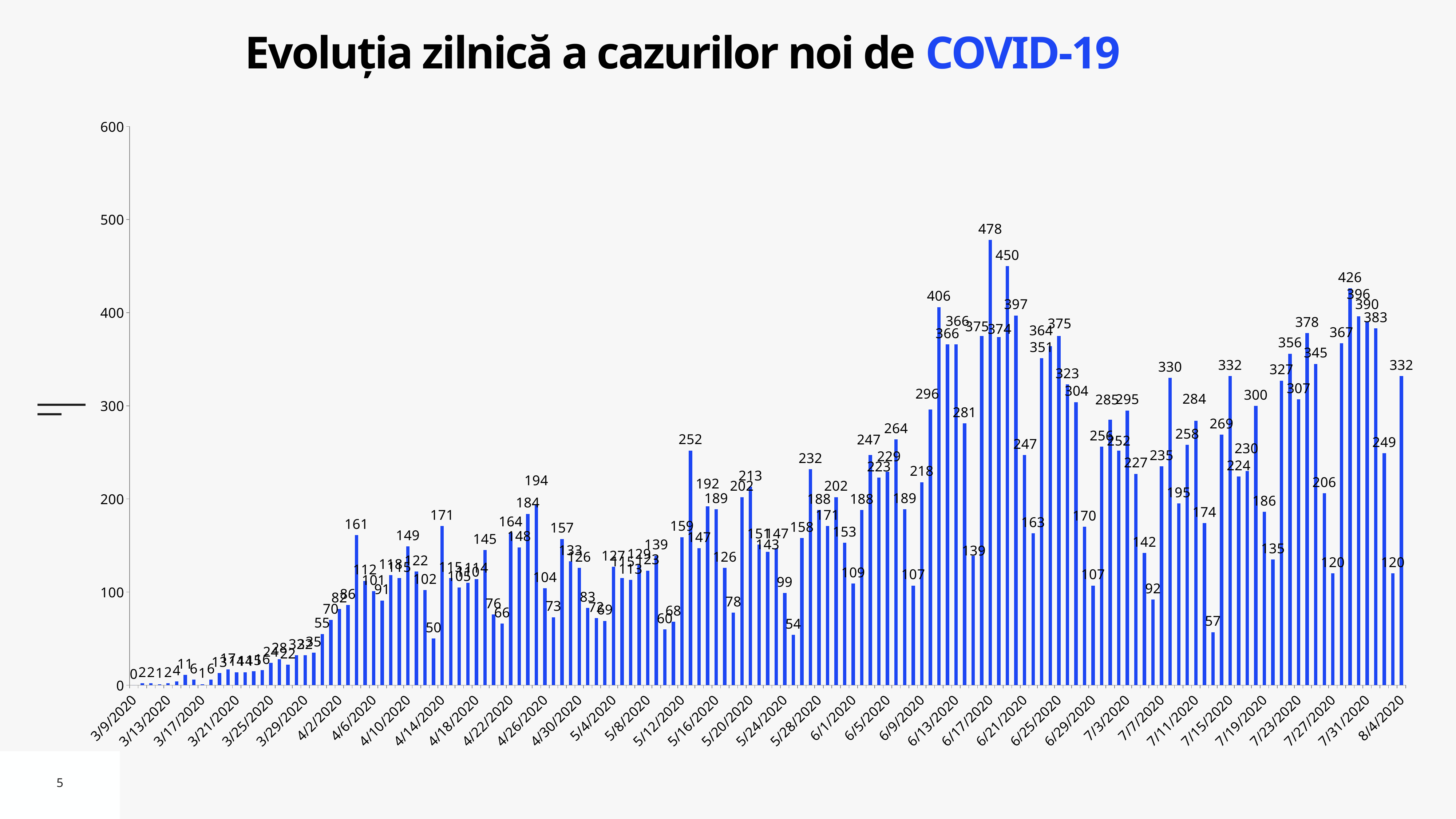
What is the second highest daily value shown in the chart? 450 Which date has the lowest value in the chart? 3/9/2020 What kind of chart is shown on the slide? bar chart What is the value for 8/4/2020? 332 What is the title of the chart? Evoluția zilnică a cazurilor noi de COVID-19 Overall, do the daily values rise or fall from March to August 2020? rise What is the difference between the two highest values, 478 and 450? 28 What is the value for 3/9/2020? 0 Which is larger, the value for 3/9/2020 or the value for 8/4/2020? 8/4/2020 What is the highest daily value shown in the chart? 478 What is the maximum value shown on the vertical axis? 600 Is the value for 8/4/2020 greater or less than 300? greater